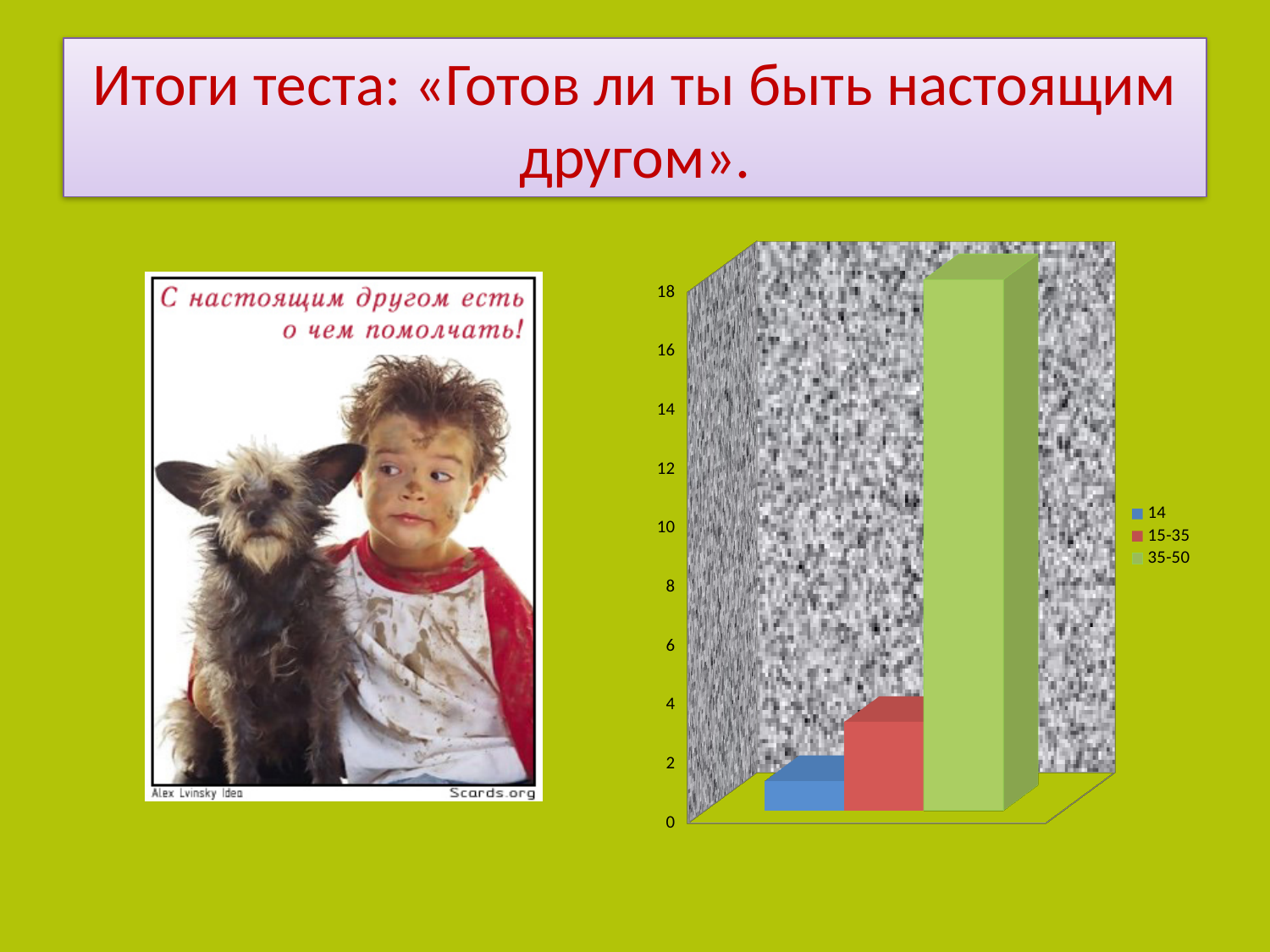
Which series has the highest bar in the chart? 35-50 Is the value for 35-50 greater or less than 16? greater How many series does the chart legend list? 3 What is the highest value shown on the chart's vertical axis? 18 Is the value for 14 greater or less than 2? less Which is larger, the bar for 35-50 or the bar for 15-35? 35-50 Is the value for 15-35 greater or less than 6? less Which series has the lowest bar in the chart? 14 What colour is the bar for the 35-50 series? green How many bars are plotted in the chart? 3 Which is larger, the bar for 15-35 or the bar for 14? 15-35 What kind of chart is shown on the slide? bar chart